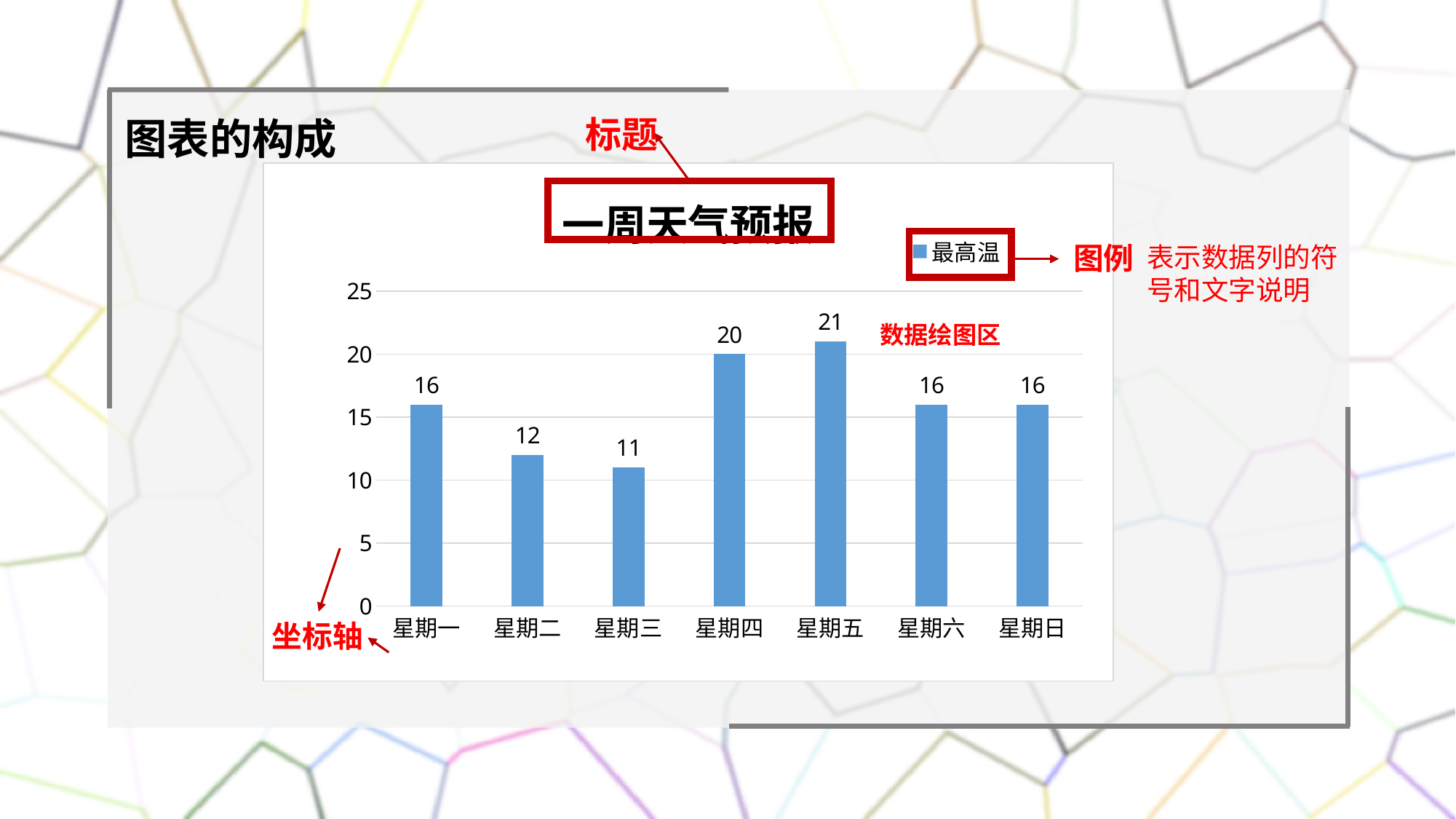
Which day has the lowest value? 星期三 What is the title of the chart? 一周天气预报 What is the value for 星期二? 12 Is the value for 星期五 greater or less than 20? greater How many days are shown on the x axis? 7 How many series does the legend list? 1 Which is larger, the value for 星期四 or the value for 星期一? 星期四 What is the value for 星期四? 20 Which day has the highest value? 星期五 What is the difference between the values for 星期五 and 星期三? 10 What kind of chart is shown? bar chart What is the value for 星期三? 11